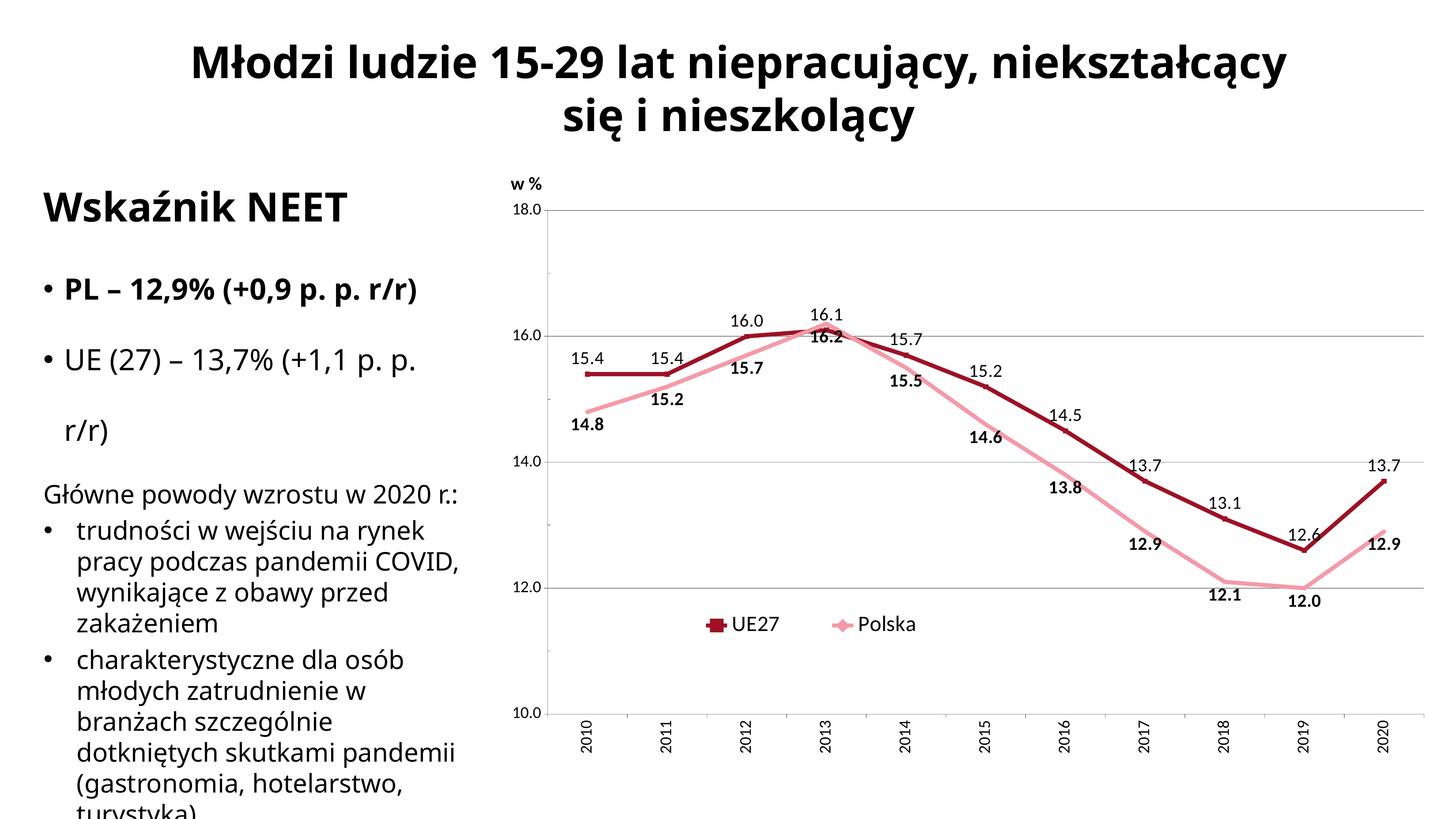
What is the value for Polska in 2019? 12.0 Which series has the higher value in 2016, UE27 or Polska? UE27 In which year is the Polska series at its highest? 2013 How many years are shown on the x axis? 11 What unit label is shown above the vertical axis of the chart? w % What is the difference between the UE27 and Polska values in 2018? 1.0 What is the value for UE27 in 2013? 16.1 In which year is the UE27 series at its lowest? 2019 What type of chart is shown on the slide? line chart What is the value for Polska in 2010? 14.8 Does the Polska series rise or fall from 2013 to 2019? fall How many series does the chart legend list? 2